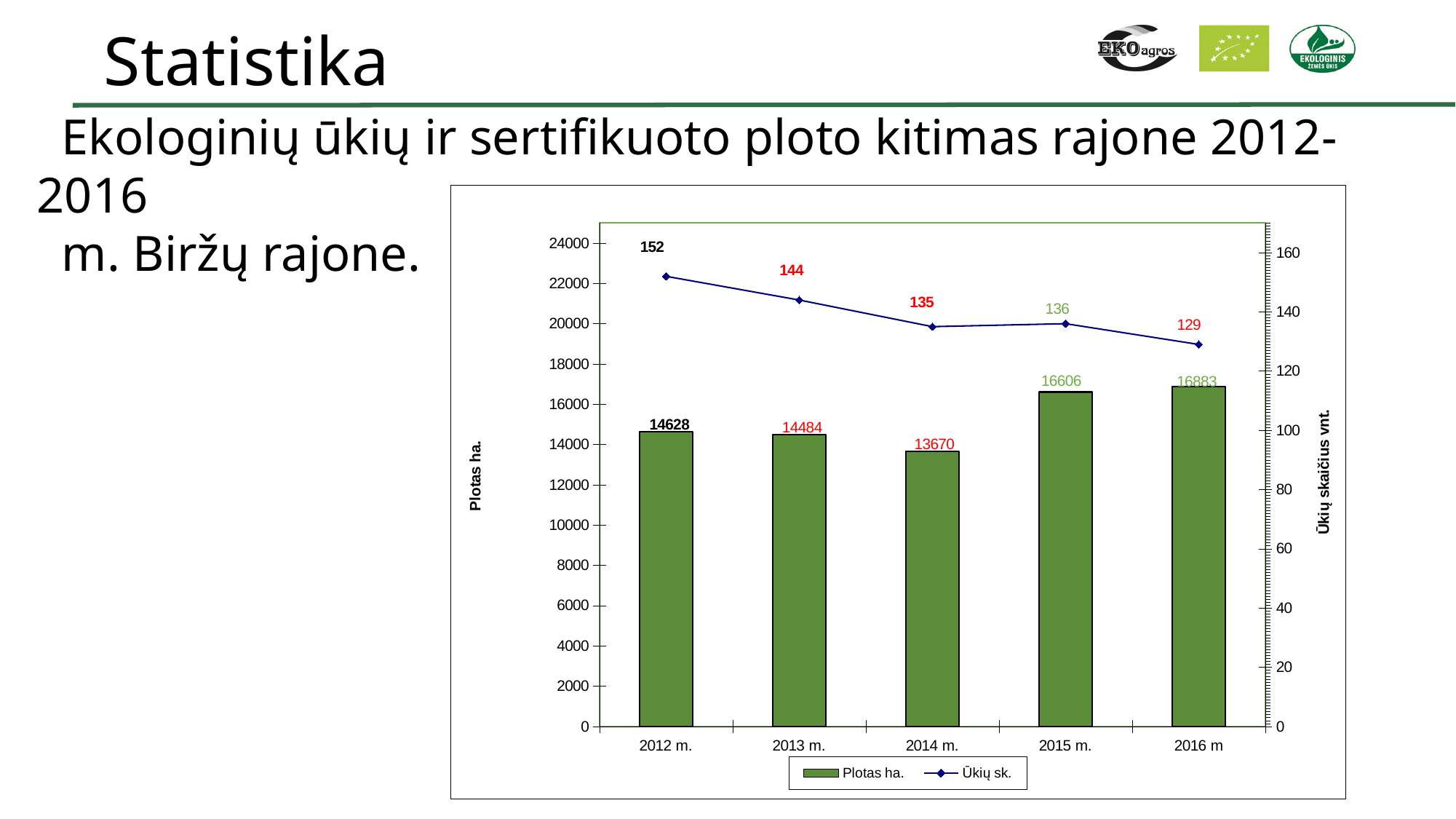
How many years are shown on the x axis? 5 Does the Ūkių sk. series generally rise or fall from 2012 m. to 2016 m? fall How many series does the legend list? 2 Which year has the lowest Plotas ha. value? 2014 m. What is the value of Plotas ha. for 2016 m? 16883 Which year has the lowest Ūkių sk. value? 2016 m What is the difference in Ūkių sk. between 2012 m. and 2013 m.? 8 What is the difference in Plotas ha. between 2015 m. and 2014 m.? 2936 Which year has the highest Plotas ha. value? 2016 m What is the value of Plotas ha. for 2014 m.? 13670 Which is larger, the Plotas ha. value for 2012 m. or for 2013 m.? 2012 m. What is the value of Ūkių sk. for 2012 m.? 152